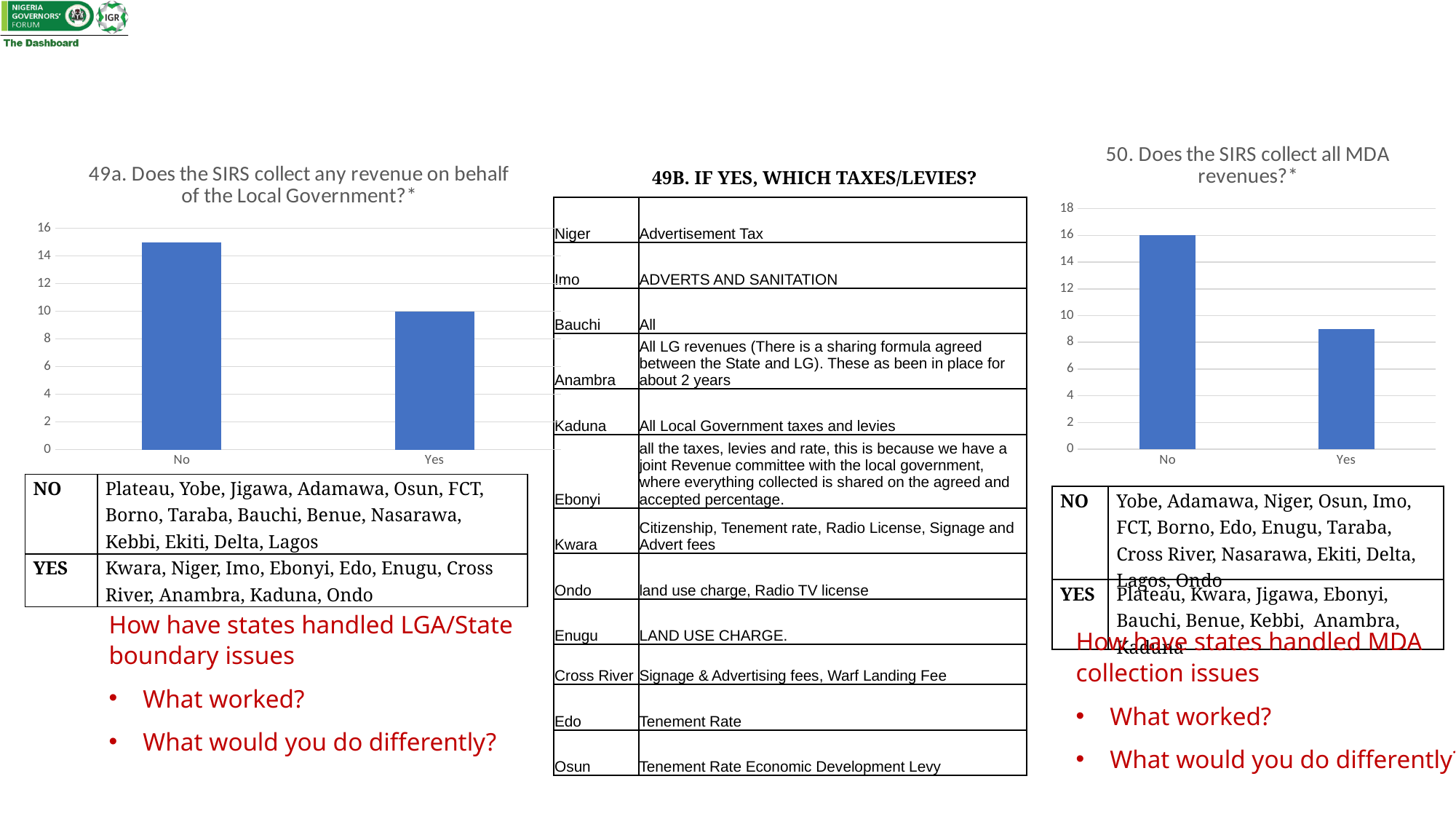
What colour are the bars on the chart titled "49a. Does the SIRS collect any revenue on behalf of the Local Government?*"? Blue What is the highest value shown on the vertical axis of the chart titled "50. Does the SIRS collect all MDA revenues?*"? 18 On the chart titled "50. Does the SIRS collect all MDA revenues?*", which category has the lowest value? Yes On the chart titled "50. Does the SIRS collect all MDA revenues?*", is the value for Yes greater or less than 10? less How many categories are shown on the chart titled "49a. Does the SIRS collect any revenue on behalf of the Local Government?*"? 2 On the chart titled "49a. Does the SIRS collect any revenue on behalf of the Local Government?*", which category has the highest value? No On the chart titled "50. Does the SIRS collect all MDA revenues?*", what is the value for No? 16 On the chart titled "50. Does the SIRS collect all MDA revenues?*", which is larger, No or Yes? No What kind of chart is the chart titled "50. Does the SIRS collect all MDA revenues?*"? Bar chart On the chart titled "49a. Does the SIRS collect any revenue on behalf of the Local Government?*", do the values rise or fall from No to Yes? Fall On the chart titled "49a. Does the SIRS collect any revenue on behalf of the Local Government?*", is the value for No greater or less than 14? greater On the chart titled "49a. Does the SIRS collect any revenue on behalf of the Local Government?*", what is the value for Yes? 10